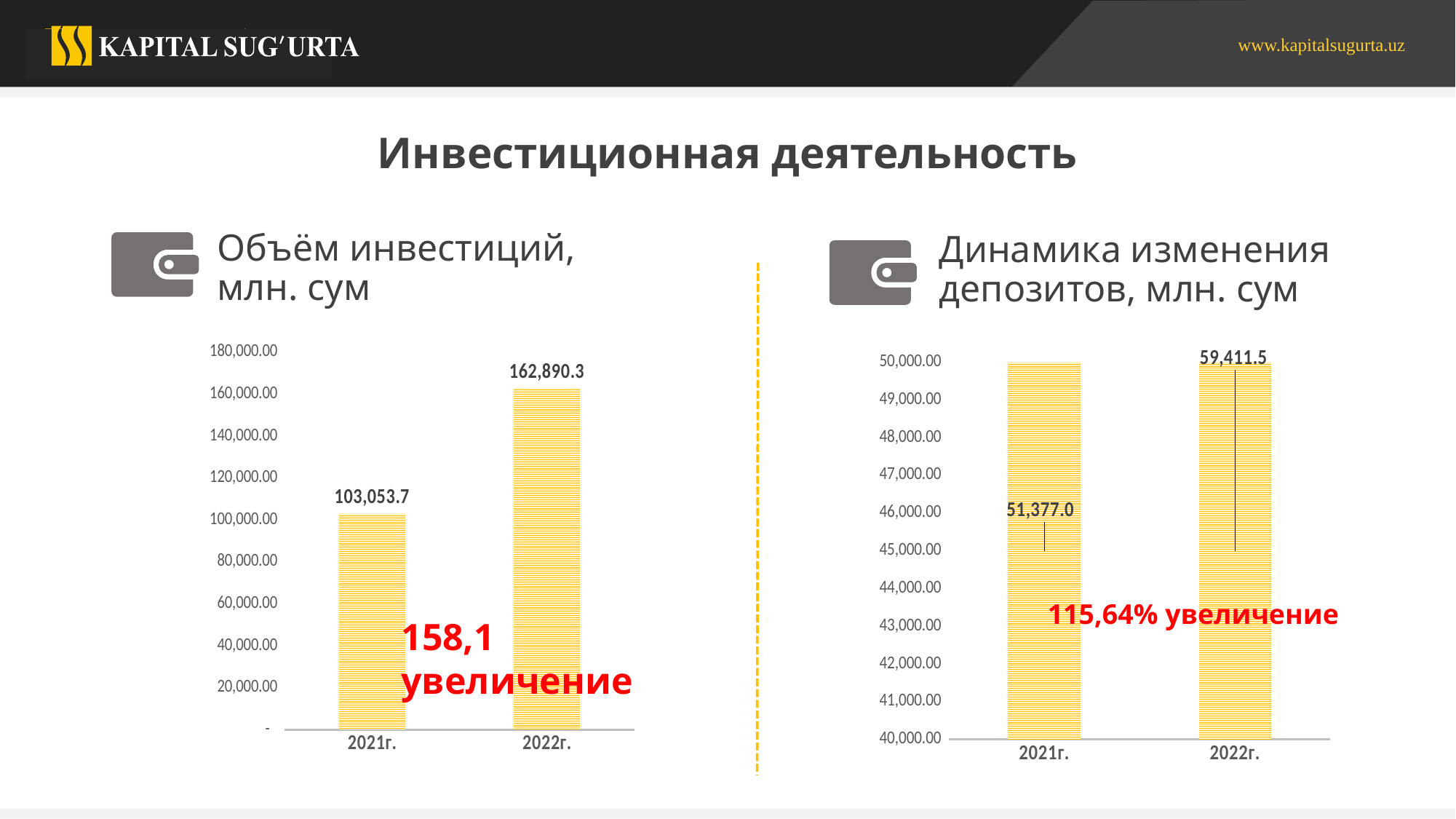
In the chart 'Объём инвестиций, млн. сум', what is the difference between the 2022г. and 2021г. values? 59,836.6 In the chart 'Динамика изменения депозитов, млн. сум', what is the value for 2021г.? 51,377.0 In the chart 'Динамика изменения депозитов, млн. сум', which year has the lowest value? 2021г. In the chart 'Объём инвестиций, млн. сум', what is the value for 2022г.? 162,890.3 In the chart 'Объём инвестиций, млн. сум', which year has the highest value? 2022г. In the chart 'Объём инвестиций, млн. сум', is the value for 2021г. greater or less than 120,000.00? less How many categories are shown on the x axis of the chart 'Объём инвестиций, млн. сум'? 2 In the chart 'Динамика изменения депозитов, млн. сум', what is the difference between the 2022г. and 2021г. values? 8,034.5 In the chart 'Объём инвестиций, млн. сум', do the values rise or fall from 2021г. to 2022г.? rise In the chart 'Динамика изменения депозитов, млн. сум', what is the value for 2022г.? 59,411.5 In the chart 'Объём инвестиций, млн. сум', what is the value for 2021г.? 103,053.7 What type of chart is the chart 'Динамика изменения депозитов, млн. сум'? bar chart